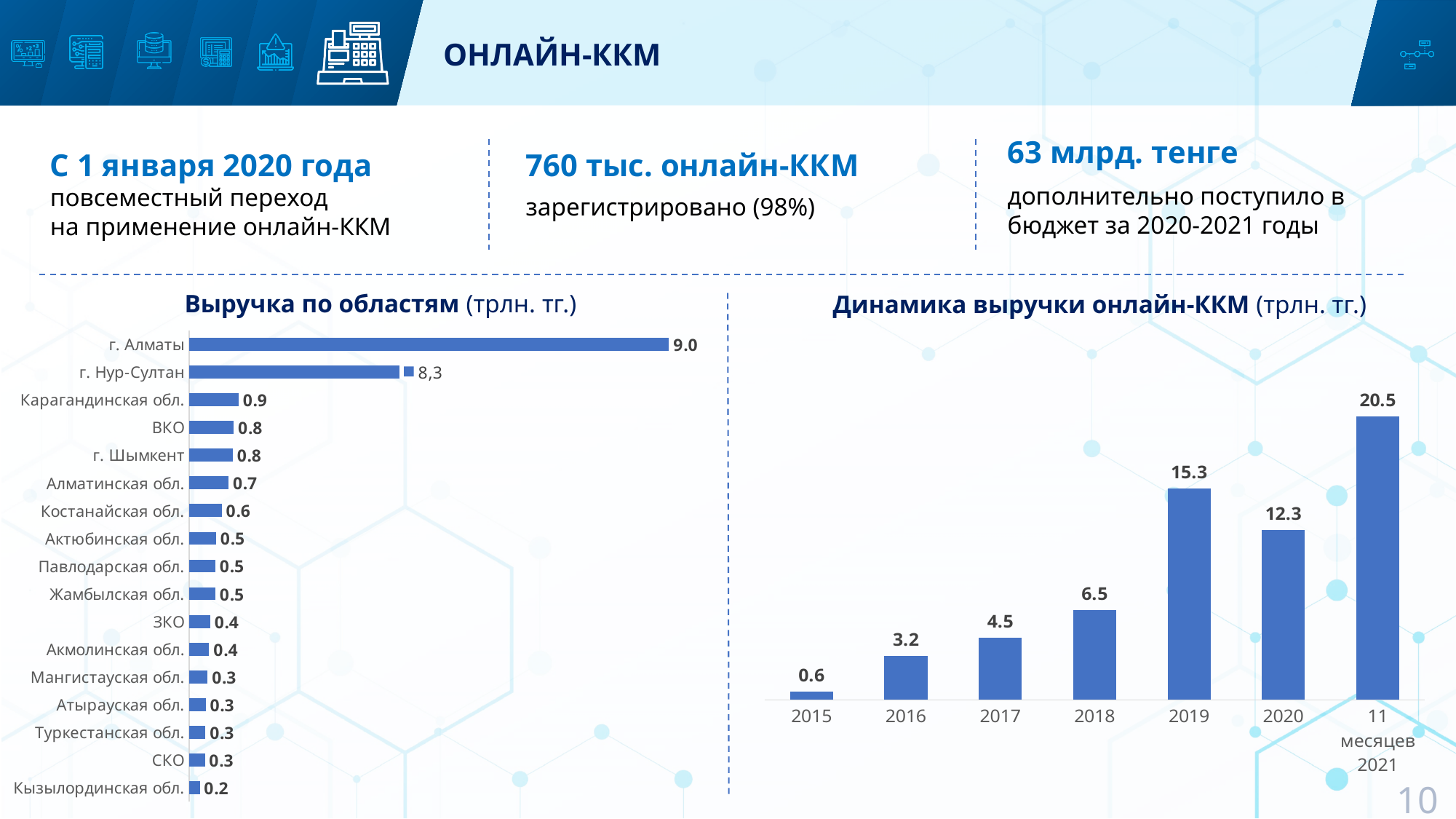
In the chart 'Динамика выручки онлайн-ККМ', which is larger, 2019 or 2020? 2019 In the chart 'Выручка по областям', what is the difference between г. Алматы and Карагандинская обл.? 8.1 In the chart 'Динамика выручки онлайн-ККМ', which year has the lowest value? 2015 In the chart 'Выручка по областям', how many categories are shown? 17 In the chart 'Динамика выручки онлайн-ККМ', what is the value for 2019? 15.3 In the chart 'Выручка по областям', which category has the highest value? г. Алматы In the chart 'Динамика выручки онлайн-ККМ', how many bars are shown? 7 In the chart 'Выручка по областям', which category has the lowest value? Кызылординская обл. In the chart 'Выручка по областям', what is the value for Карагандинская обл.? 0.9 In the chart 'Динамика выручки онлайн-ККМ', what is the value for 11 месяцев 2021? 20.5 In the chart 'Динамика выручки онлайн-ККМ', what is the difference between 2018 and 2017? 2.0 What type of chart is 'Динамика выручки онлайн-ККМ'? bar chart